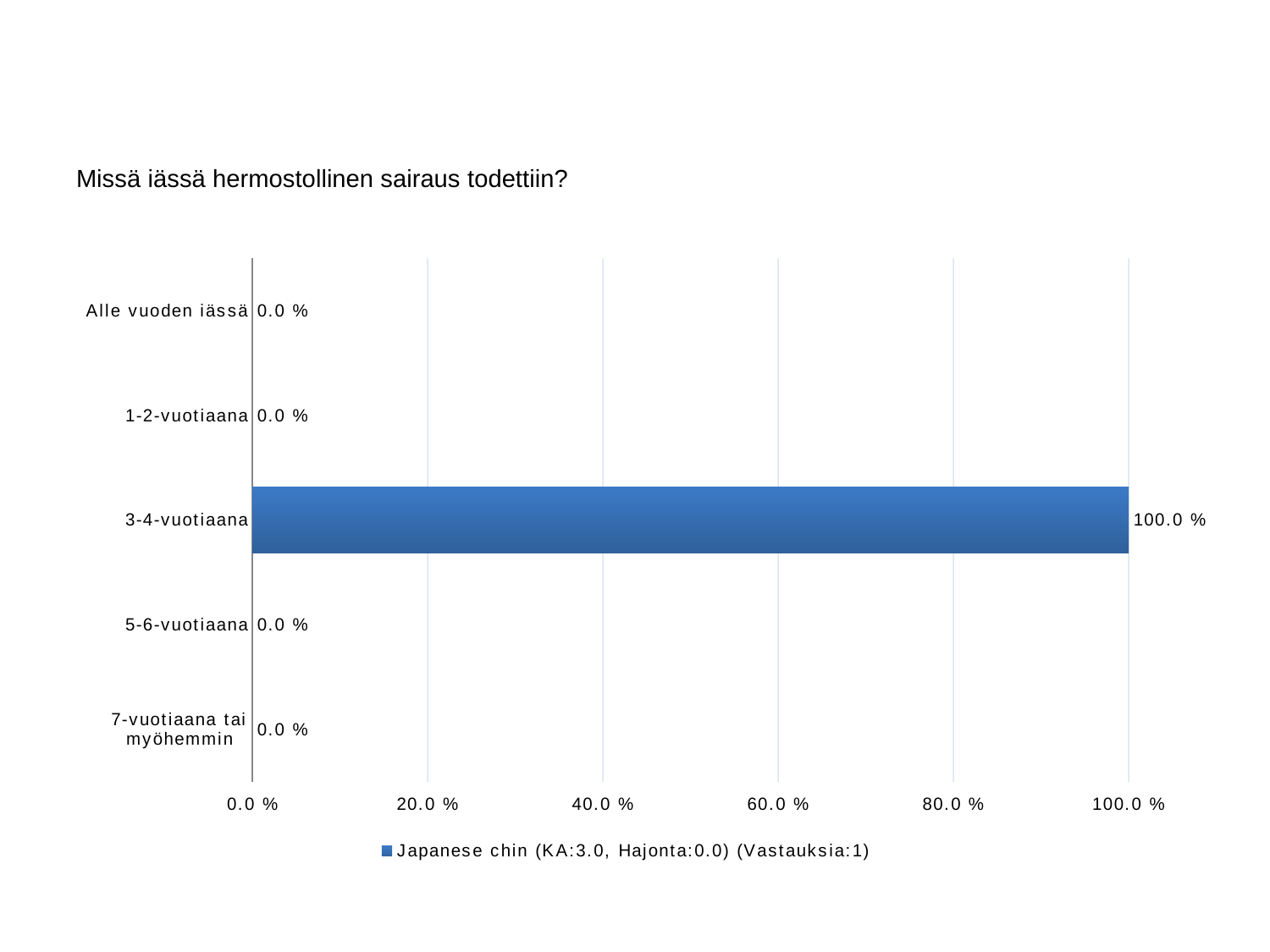
What is the value for 5-6-vuotiaana? 0.0 % What is the value for 3-4-vuotiaana? 100.0 % What is the title of the chart? Missä iässä hermostollinen sairaus todettiin? What is the difference between the values for 3-4-vuotiaana and 1-2-vuotiaana? 100.0 % What is the value for Alle vuoden iässä? 0.0 % What is the value for 7-vuotiaana tai myöhemmin? 0.0 % Which is larger, the value for 3-4-vuotiaana or the value for 5-6-vuotiaana? 3-4-vuotiaana Is the value for 3-4-vuotiaana greater or less than 80.0 %? greater What kind of chart is shown on the slide? bar chart Which category has the highest value? 3-4-vuotiaana How many series does the legend list? 1 How many categories are shown on the chart? 5